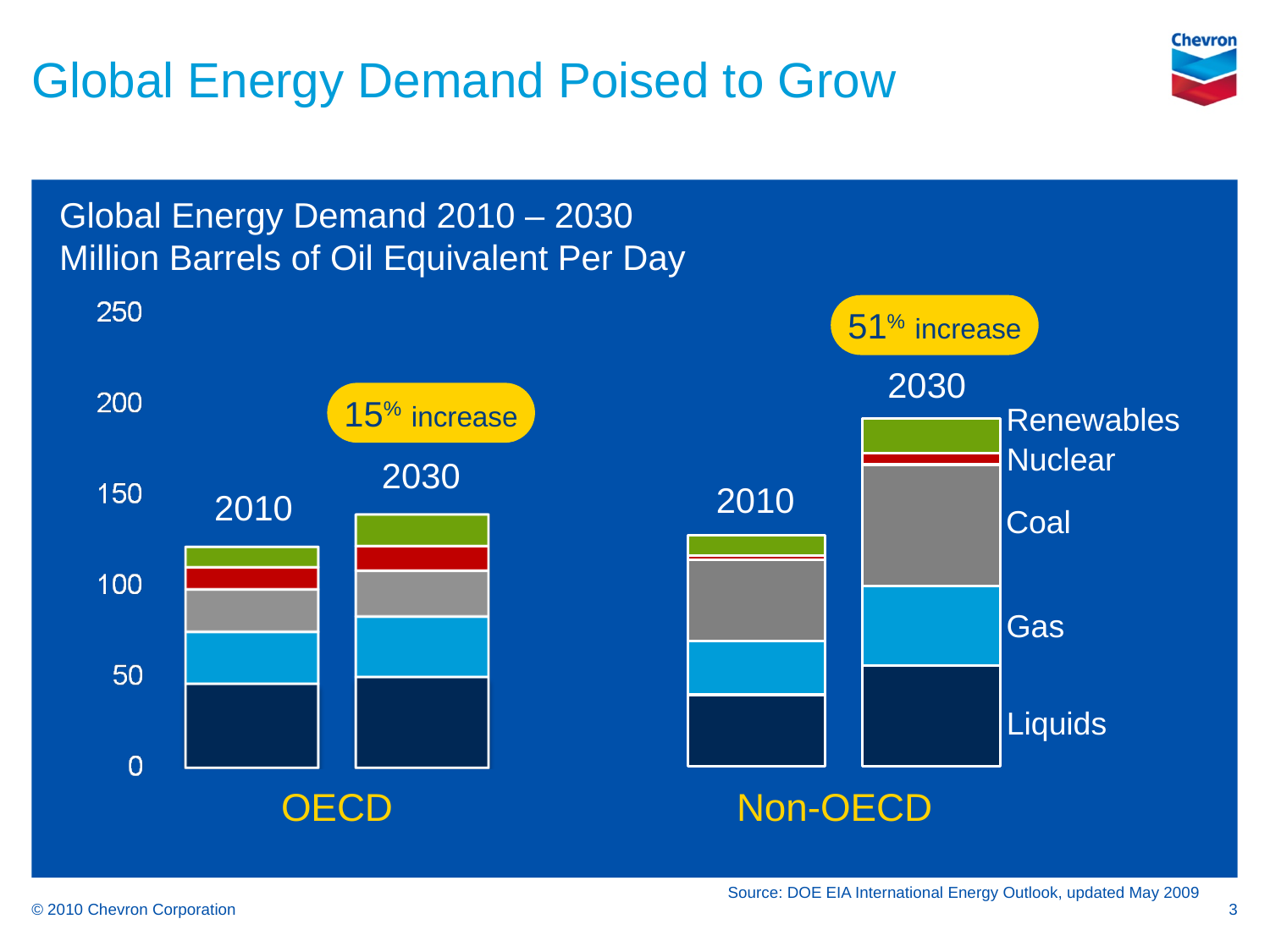
What percentage increase is shown for OECD energy demand from 2010 to 2030? 15% increase How many bars are plotted in the chart? 4 Is the total for OECD 2030 greater or less than 150? less What unit is the chart measured in, according to its subtitle? Million Barrels of Oil Equivalent Per Day Is the total for Non-OECD 2030 greater or less than 150? greater Which bar has the highest total energy demand? Non-OECD 2030 How many energy source categories are labelled in the stacked bars? 5 What kind of chart is shown on the slide? Stacked bar chart Is the total for OECD 2010 greater or less than 100? greater Which is larger, the total for OECD 2030 or the total for Non-OECD 2030? Non-OECD 2030 What percentage increase is shown for Non-OECD energy demand from 2010 to 2030? 51% increase Does energy demand rise or fall from 2010 to 2030 for both OECD and Non-OECD? Rises